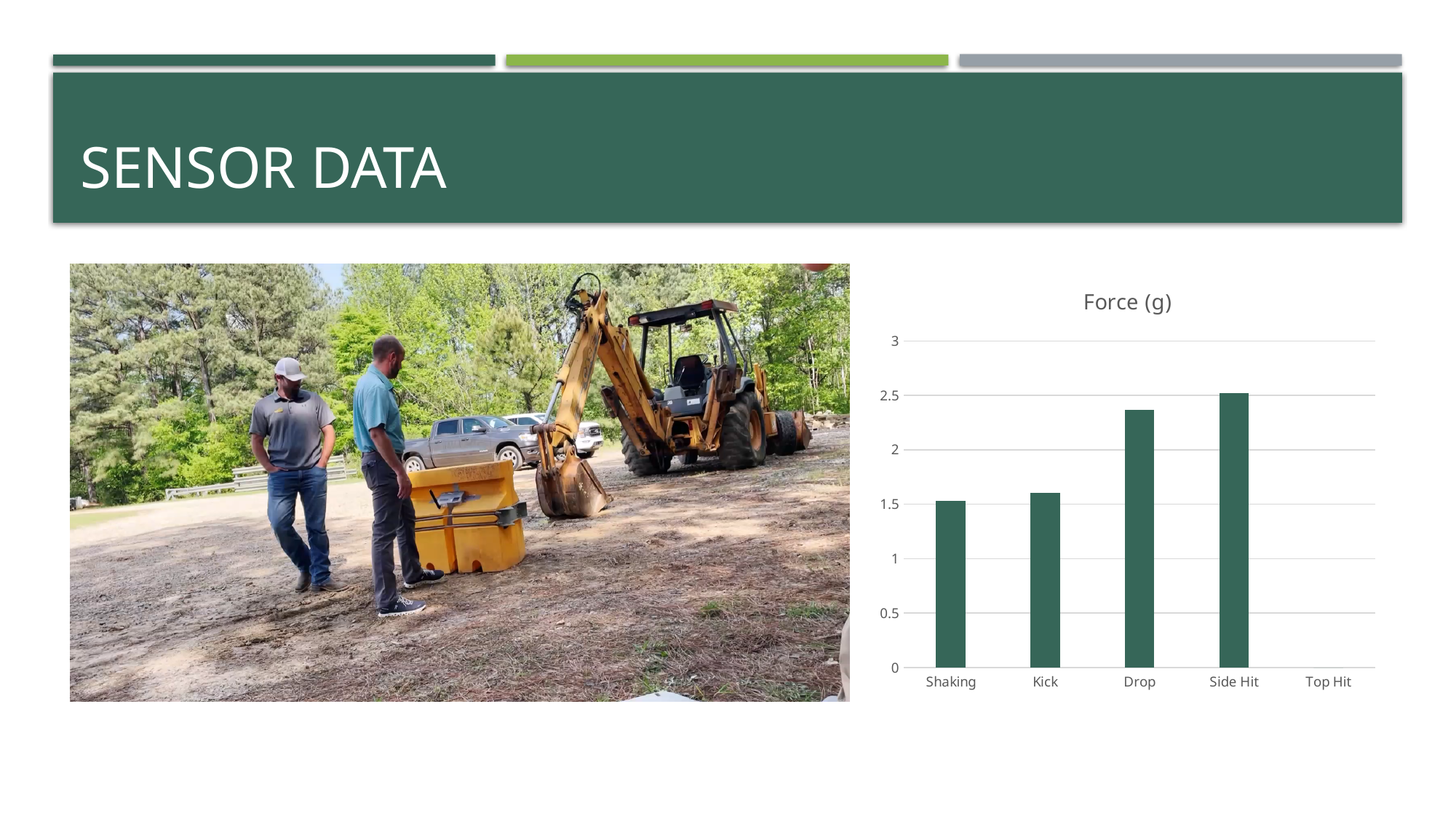
Which category has the highest value in the chart? Side Hit Is the value for Kick greater or less than 2? less Is the value for Drop greater or less than 2? greater Is the value for Side Hit greater or less than 2? greater What kind of chart is shown on the slide? bar chart How many categories are shown on the x axis of the chart? 5 What is the title of the chart? Force (g) Which is larger, the value for Side Hit or the value for Shaking? Side Hit Which is larger, the value for Drop or the value for Kick? Drop Do the values rise or fall from Shaking to Side Hit along the x axis? rise